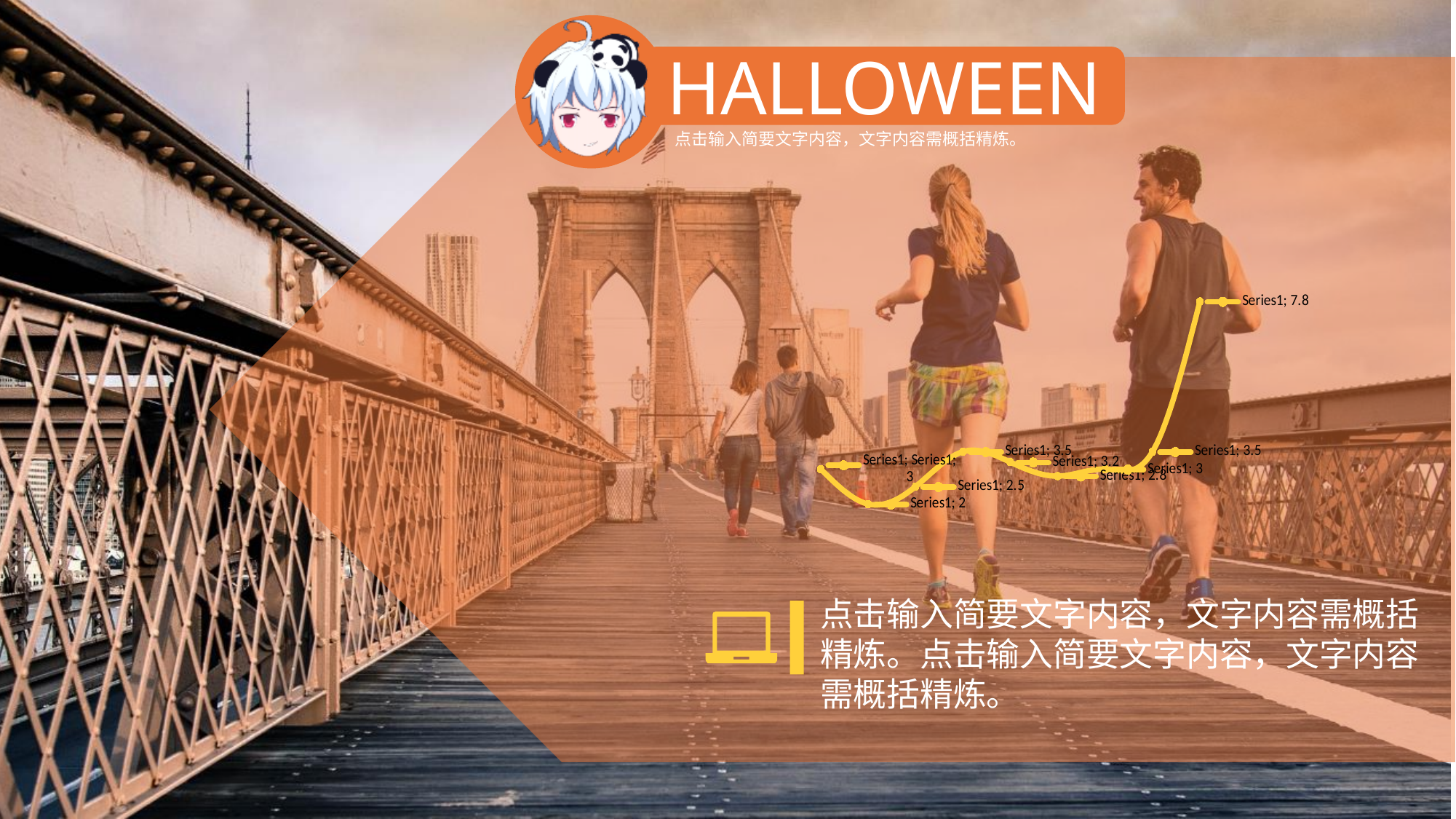
What is the difference between the highest labelled value (7.8) and the lowest labelled value (2) on the line chart? 5.8 What colour is the line in the chart? yellow What is the highest value labelled on the line chart? 7.8 What series name appears in the data labels of the line chart? Series1 What is the value of the rightmost point on the line chart? 7.8 What kind of chart is shown on the slide? line chart Which is larger on the line chart: the point labelled 3.2 or the point labelled 2.8? 3.2 What is the lowest value labelled on the line chart? 2 Does the line chart rise or fall between the point labelled 3.5 and the final point labelled 7.8? rise